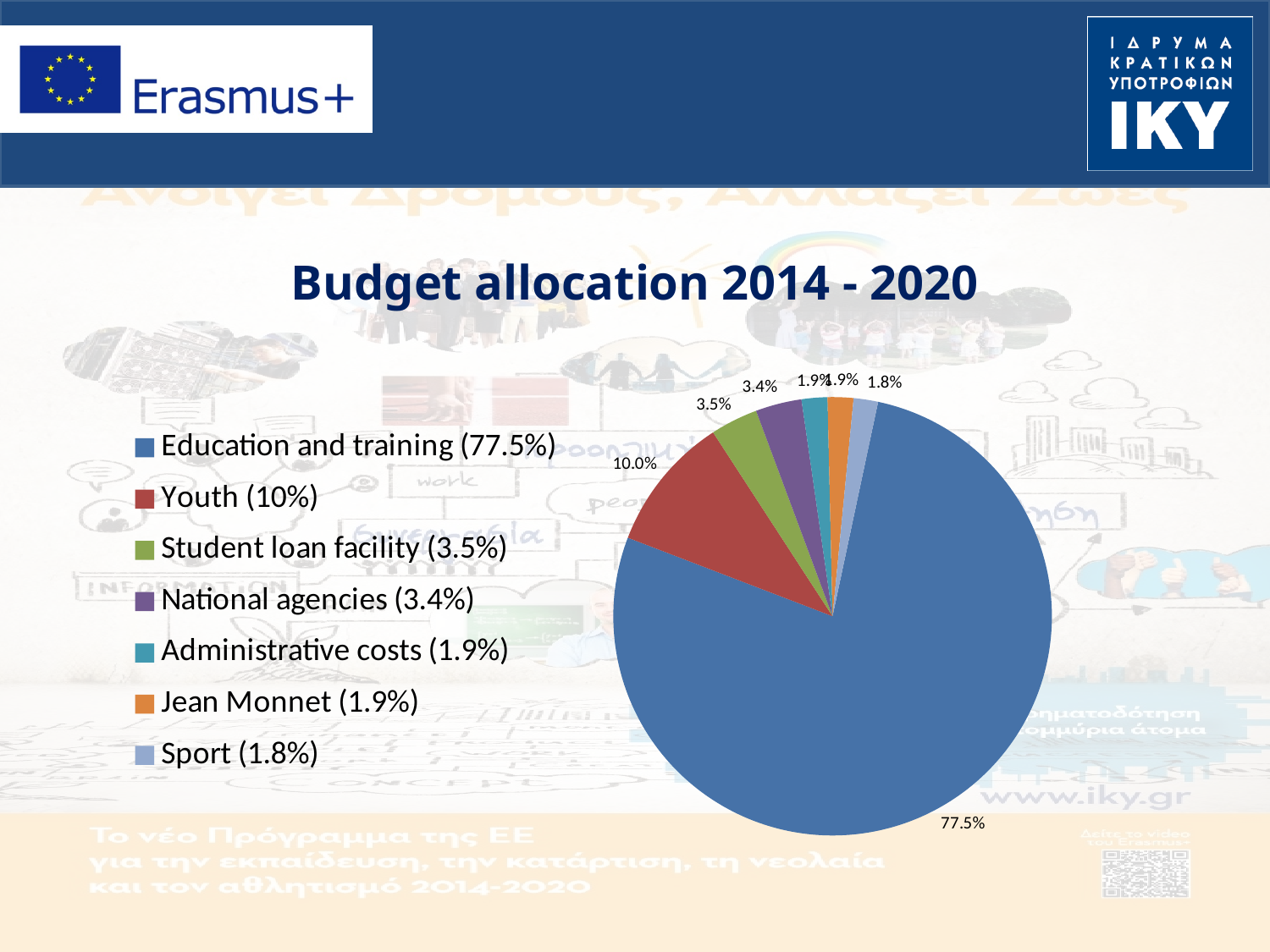
What share of the budget goes to Education and training? 77.5% Which category has the largest slice of the pie? Education and training What is the value shown for Sport? 1.8% Which legend entry is shown in orange? Jean Monnet (1.9%) Which category has the smallest slice of the pie? Sport How many slices does the pie chart have? 7 What is the difference between the Education and training share and the Youth share? 67.5% What is the value shown for National agencies? 3.4% What is the title of the chart? Budget allocation 2014 - 2020 Which is larger, the share for Youth or the share for Student loan facility? Youth What is the value shown for Student loan facility? 3.5% What kind of chart is shown on the slide? pie chart